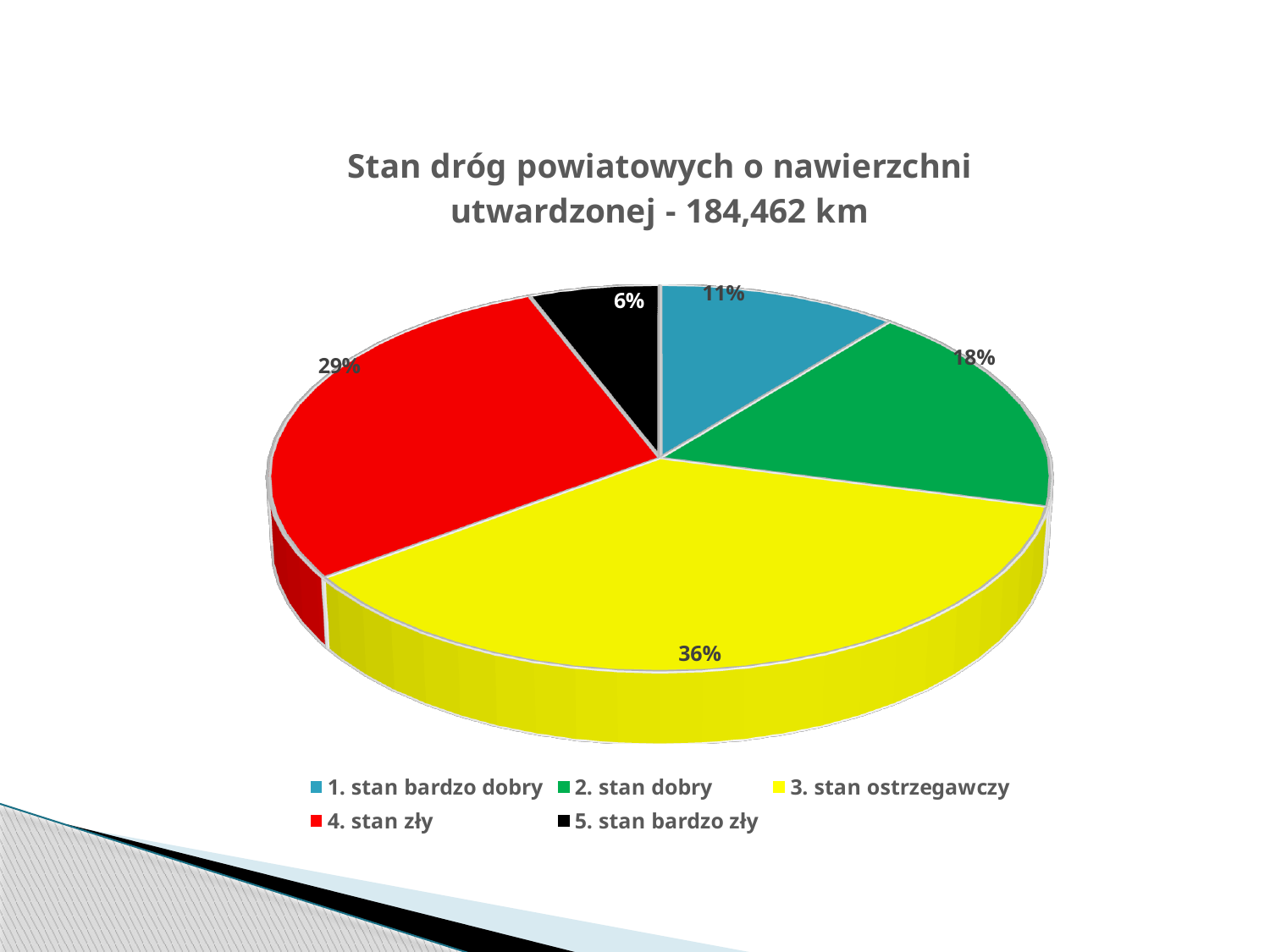
What kind of chart is shown on the slide? pie chart What share of the pie does '5. stan bardzo zły' have? 6% Which category has the smallest slice of the pie? 5. stan bardzo zły What share of the pie does '1. stan bardzo dobry' have? 11% What share of the pie does '3. stan ostrzegawczy' have? 36% How many categories does the pie chart have? 5 Which is larger, the share for '2. stan dobry' or the share for '1. stan bardzo dobry'? 2. stan dobry Which category has the largest slice of the pie? 3. stan ostrzegawczy What is the difference in percentage points between '3. stan ostrzegawczy' and '4. stan zły'? 7% What is the title of the chart? Stan dróg powiatowych o nawierzchni utwardzonej - 184,462 km